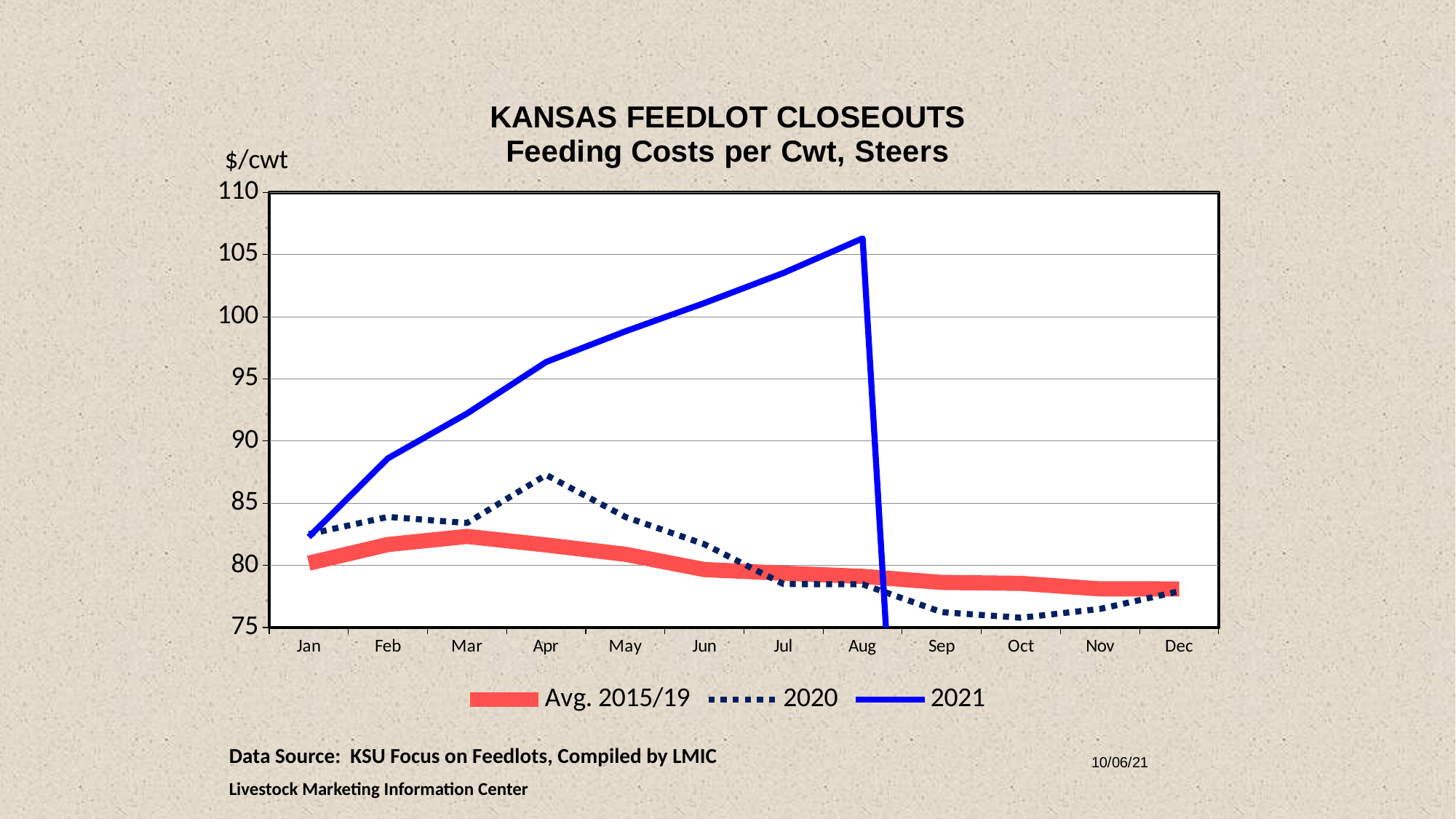
What kind of chart is shown on the slide? line chart How many months are shown along the x axis? 12 In Apr, which series is higher, 2020 or Avg. 2015/19? 2020 Is the value for 2021 in Jan greater or less than 85? less Is the value for 2021 in Aug greater or less than 105? greater Does the 2021 series rise or fall from Jan to Aug? rise Is the value for 2021 in May greater or less than 95? greater How many series does the legend list? 3 In Oct, which series is higher, Avg. 2015/19 or 2020? Avg. 2015/19 In which month does the 2021 series reach its highest value? Aug In which month does the 2020 series reach its highest value? Apr